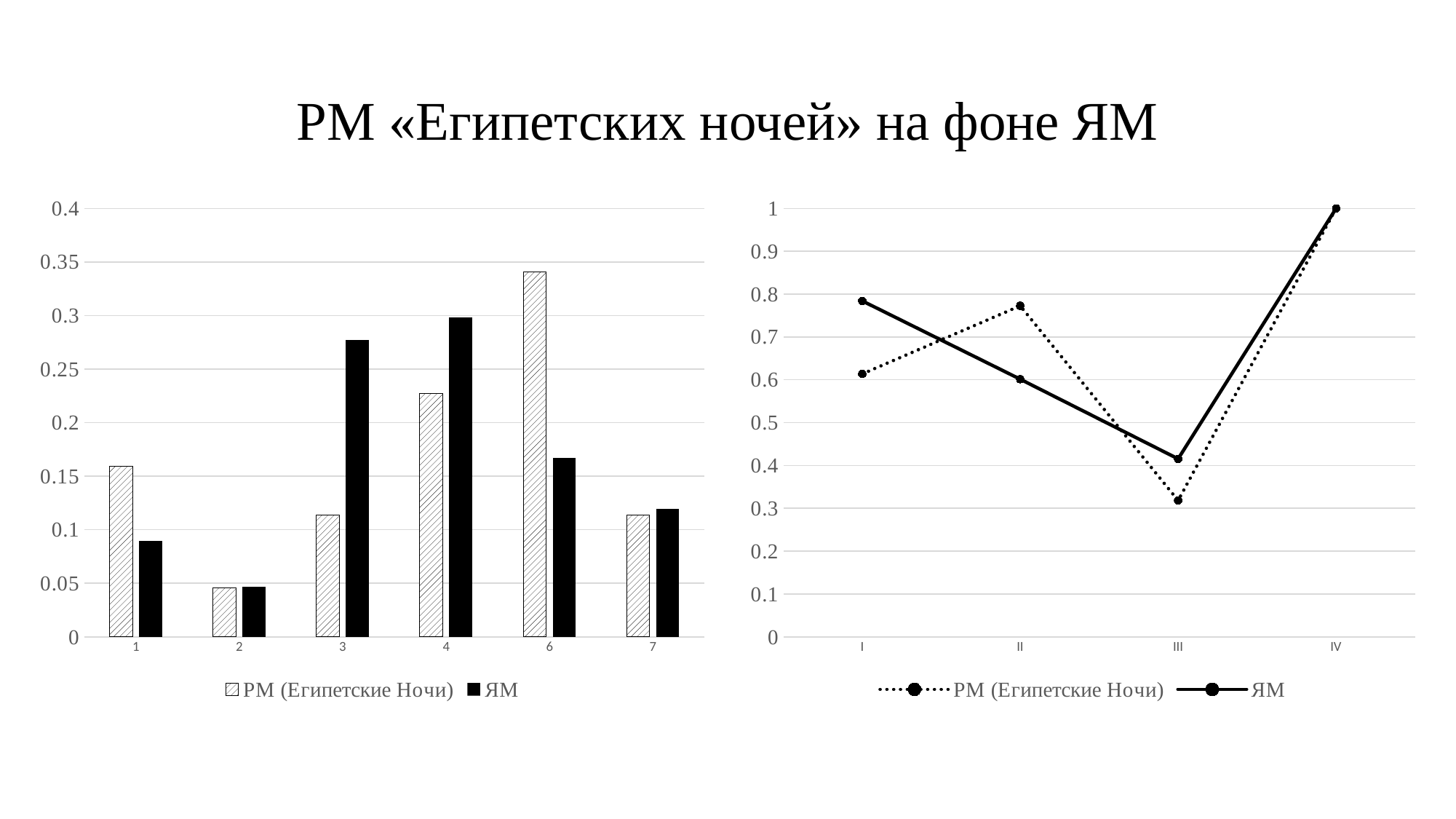
What kind of chart is the chart on the right of the slide? line chart In the bar chart on the left, which category has the highest value for ЯМ? 4 What kind of chart is the chart on the left of the slide? bar chart In the bar chart on the left, how many series does the legend list? 2 In the line chart on the right, what is the value for ЯМ at IV? 1 In the line chart on the right, at which point is the value for РМ (Египетские Ночи) lowest? III In the line chart on the right, at point I, which series has the larger value: РМ (Египетские Ночи) or ЯМ? ЯМ In the bar chart on the left, how many categories are shown on the x axis? 6 In the bar chart on the left, for category 3, which series has the larger value: РМ (Египетские Ночи) or ЯМ? ЯМ In the bar chart on the left, which category has the highest value for РМ (Египетские Ночи)? 6 In the bar chart on the left, is the value for РМ (Египетские Ночи) at category 6 greater or less than 0.3? greater In the bar chart on the left, which category has the lowest value for РМ (Египетские Ночи)? 2